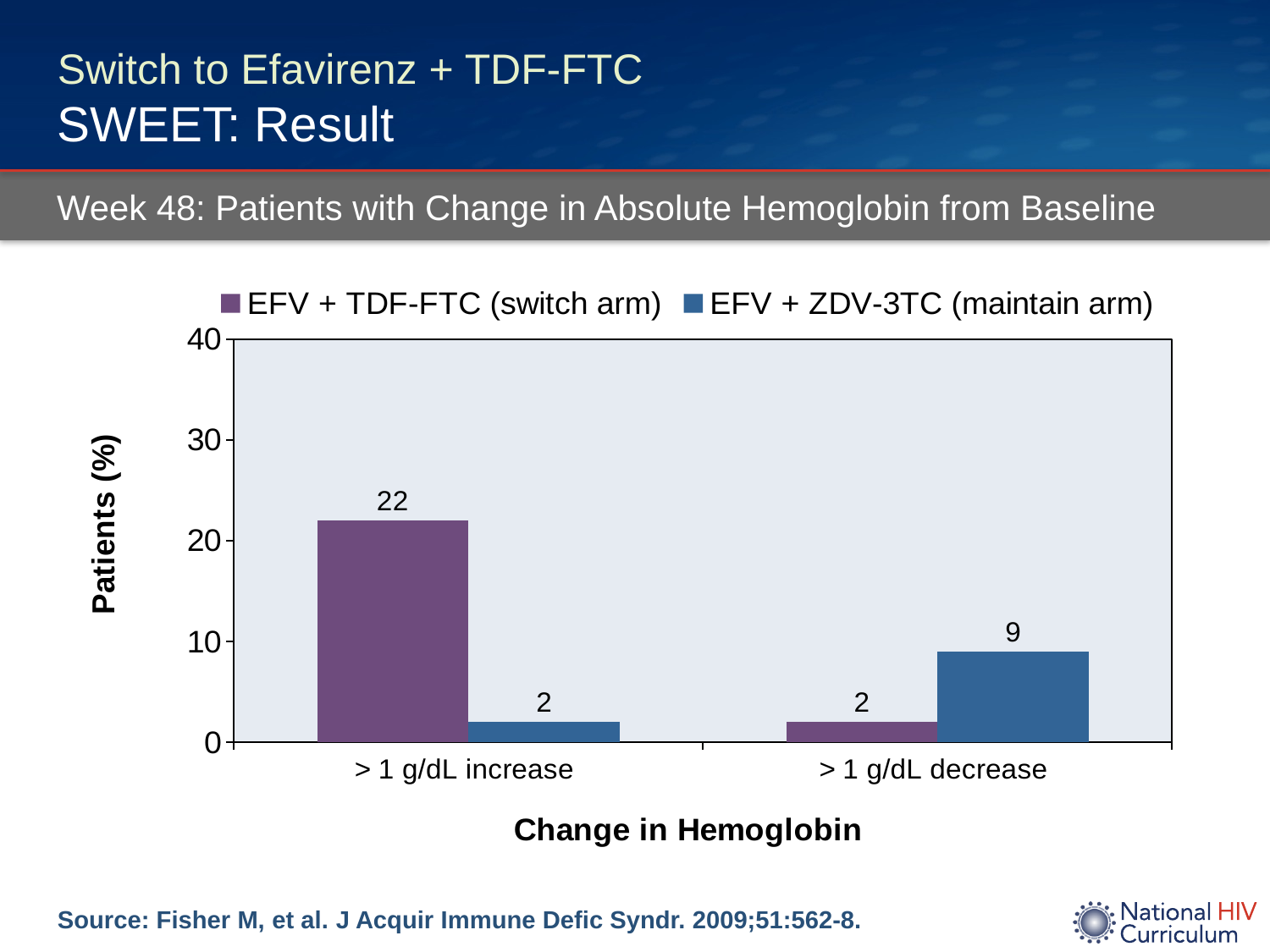
What percentage of patients in the EFV + TDF-FTC (switch arm) had a > 1 g/dL increase in hemoglobin? 22 What is the difference between the maintain arm and switch arm values for > 1 g/dL decrease? 7 What percentage of patients in the EFV + ZDV-3TC (maintain arm) had a > 1 g/dL decrease in hemoglobin? 9 Which series has the highest value in the > 1 g/dL increase category? EFV + TDF-FTC (switch arm) How many categories are shown on the x axis? 2 How many series does the legend list? 2 What is the difference between the switch arm and maintain arm values for > 1 g/dL increase? 20 What is the value for the EFV + TDF-FTC (switch arm) in the > 1 g/dL decrease category? 2 What kind of chart is shown on the slide? Bar chart What is the value for the EFV + ZDV-3TC (maintain arm) in the > 1 g/dL increase category? 2 In the > 1 g/dL decrease category, which arm has the larger value? EFV + ZDV-3TC (maintain arm) Is the value for the switch arm in the > 1 g/dL increase category greater or less than 20? greater